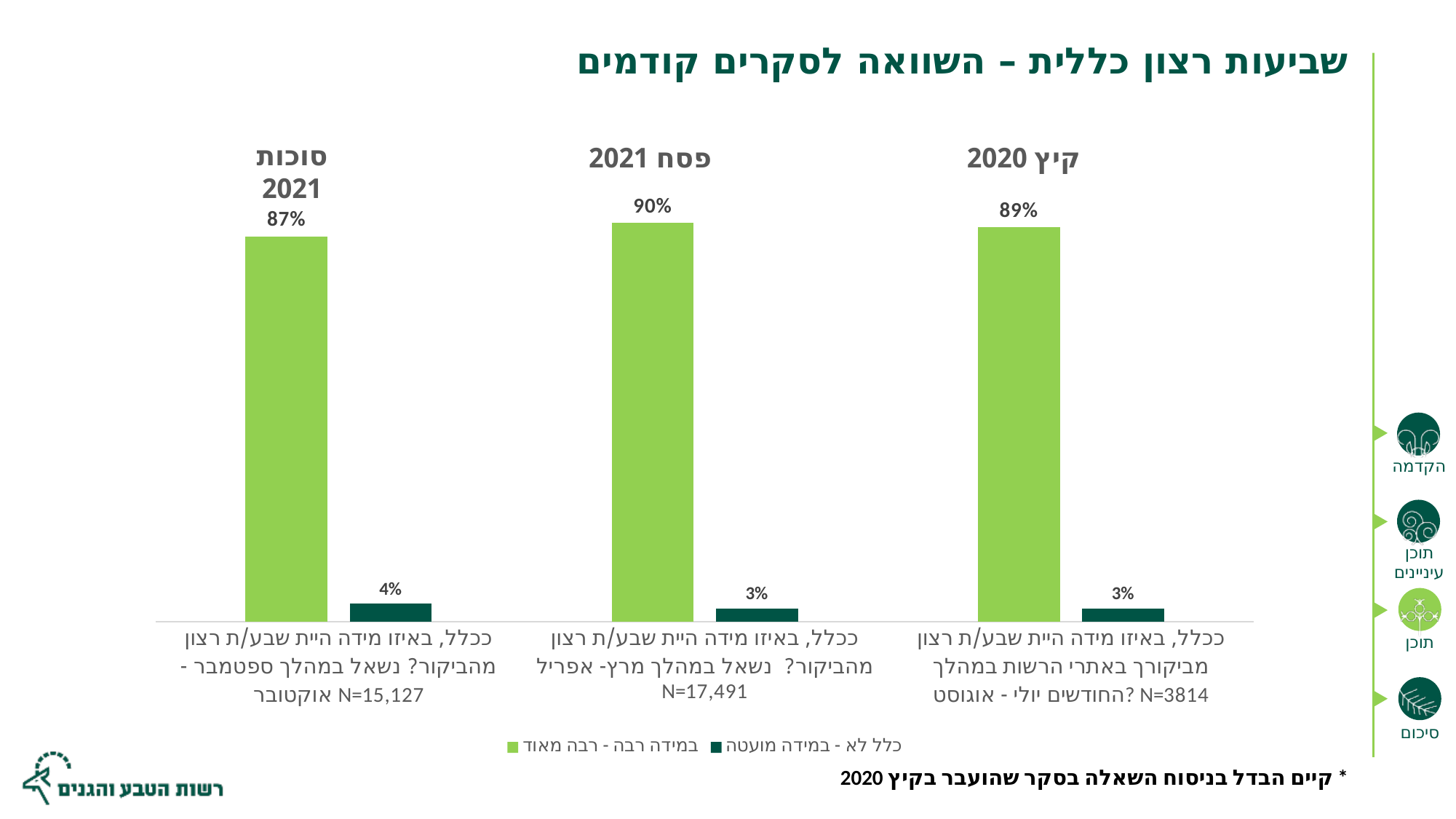
What is the difference between the "במידה רבה - רבה מאוד" value in the "פסח 2021" chart and the one in the "קיץ 2020" chart? 1% How many series does the legend list? 2 In the chart titled "סוכות 2021", what is the value for "כלל לא - במידה מועטה"? 4% Across the three charts, which survey period has the lowest value for "במידה רבה - רבה מאוד"? סוכות 2021 Which is larger: the "כלל לא - במידה מועטה" value in the "סוכות 2021" chart or in the "פסח 2021" chart? סוכות 2021 In the chart titled "קיץ 2020", what is the value for "כלל לא - במידה מועטה"? 3% In the chart titled "סוכות 2021", what is the difference between the "במידה רבה - רבה מאוד" value and the "כלל לא - במידה מועטה" value? 83% Which legend entry is shown in light green? במידה רבה - רבה מאוד What kind of chart is used on this slide? Bar chart In the chart titled "פסח 2021", what is the value for "במידה רבה - רבה מאוד"? 90% In the chart titled "קיץ 2020", what is the value for "במידה רבה - רבה מאוד"? 89% Across the three charts, which survey period has the highest value for "במידה רבה - רבה מאוד"? פסח 2021